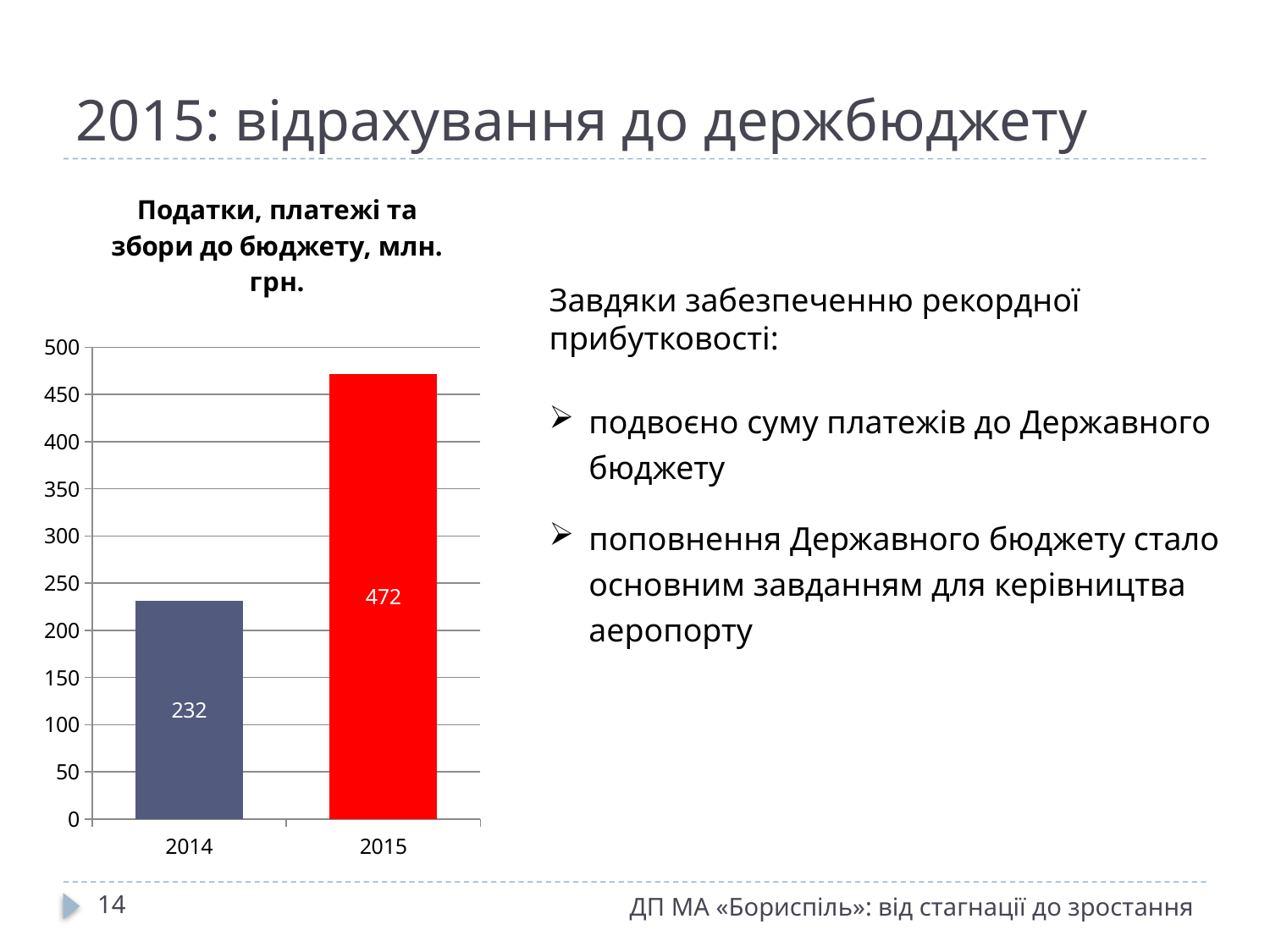
What kind of chart is shown on the slide? bar chart What is the title of the chart? Податки, платежі та збори до бюджету, млн. грн. Which is larger, the value for 2014 or the value for 2015? 2015 What is the value for 2015? 472 What is the difference between the values for 2015 and 2014? 240 Do the values rise or fall from 2014 to 2015? rise Is the value for 2015 greater or less than 450? greater Which year has the lowest value? 2014 Is the value for 2014 greater or less than 250? less Which year has the highest value? 2015 What is the value for 2014? 232 How many categories are shown on the x axis? 2